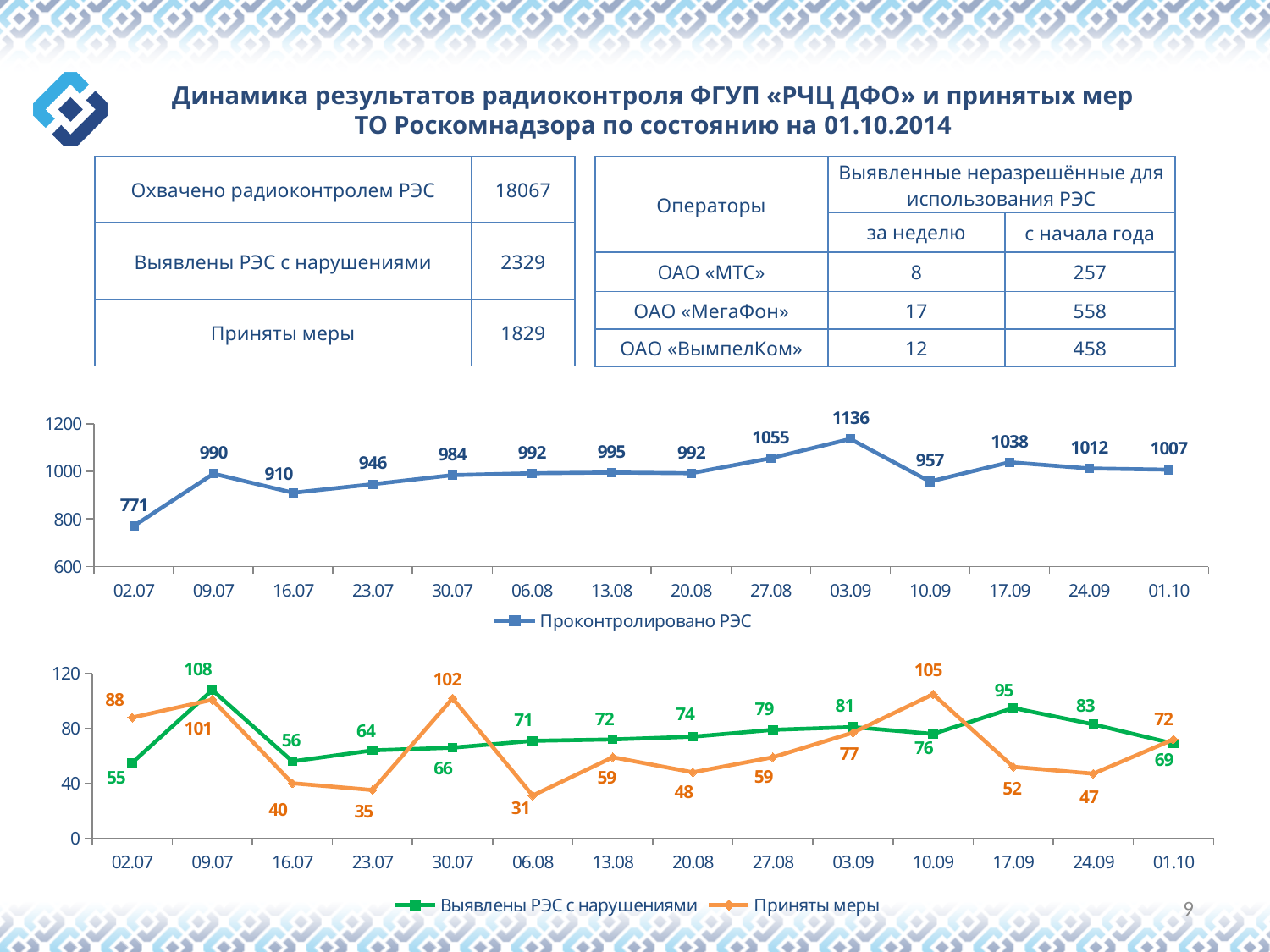
In the bottom chart, on which date is Приняты меры lowest? 06.08 In the top chart (Проконтролировано РЭС), which date has the lowest value? 02.07 In the top chart (Проконтролировано РЭС), how many data points are plotted? 14 In the bottom chart, on which date does Выявлены РЭС с нарушениями reach its highest value? 09.07 In the top chart (Проконтролировано РЭС), what is the difference between the values for 03.09 and 10.09? 179 In the bottom chart, which is larger on 10.09: Выявлены РЭС с нарушениями or Приняты меры? Приняты меры In the bottom chart, what is the value of Приняты меры for 30.07? 102 In the top chart (Проконтролировано РЭС), is the value for 27.08 greater or less than 1000? greater In the top chart (Проконтролировано РЭС), what is the value for 03.09? 1136 How many series does the legend of the bottom chart list? 2 In the bottom chart, what is the value of Выявлены РЭС с нарушениями for 17.09? 95 In the bottom chart, what is the difference between Выявлены РЭС с нарушениями and Приняты меры on 06.08? 40